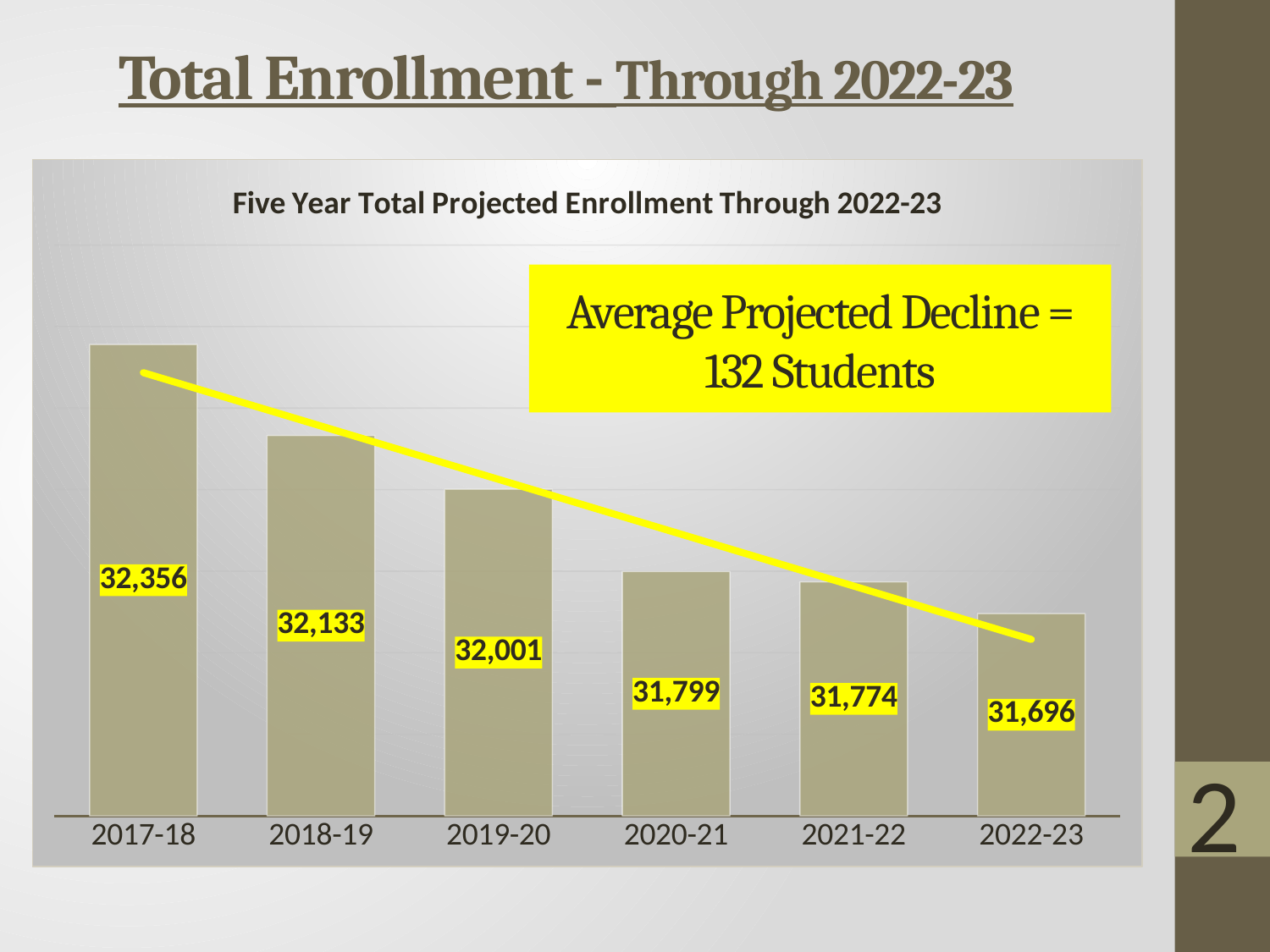
Which year has the highest enrollment? 2017-18 How many years are shown on the x axis? 6 What is the difference in enrollment between 2017-18 and 2022-23? 660 What is the projected enrollment for 2022-23? 31,696 Which year has higher enrollment, 2019-20 or 2020-21? 2019-20 What is the title of the chart? Five Year Total Projected Enrollment Through 2022-23 What is the projected enrollment for 2019-20? 32,001 What is the difference in enrollment between 2018-19 and 2019-20? 132 What kind of chart is shown? Bar chart What average projected decline is stated in the yellow box on the chart? 132 Students Which year has the lowest enrollment? 2022-23 Do enrollment values rise or fall from 2017-18 to 2022-23? Fall